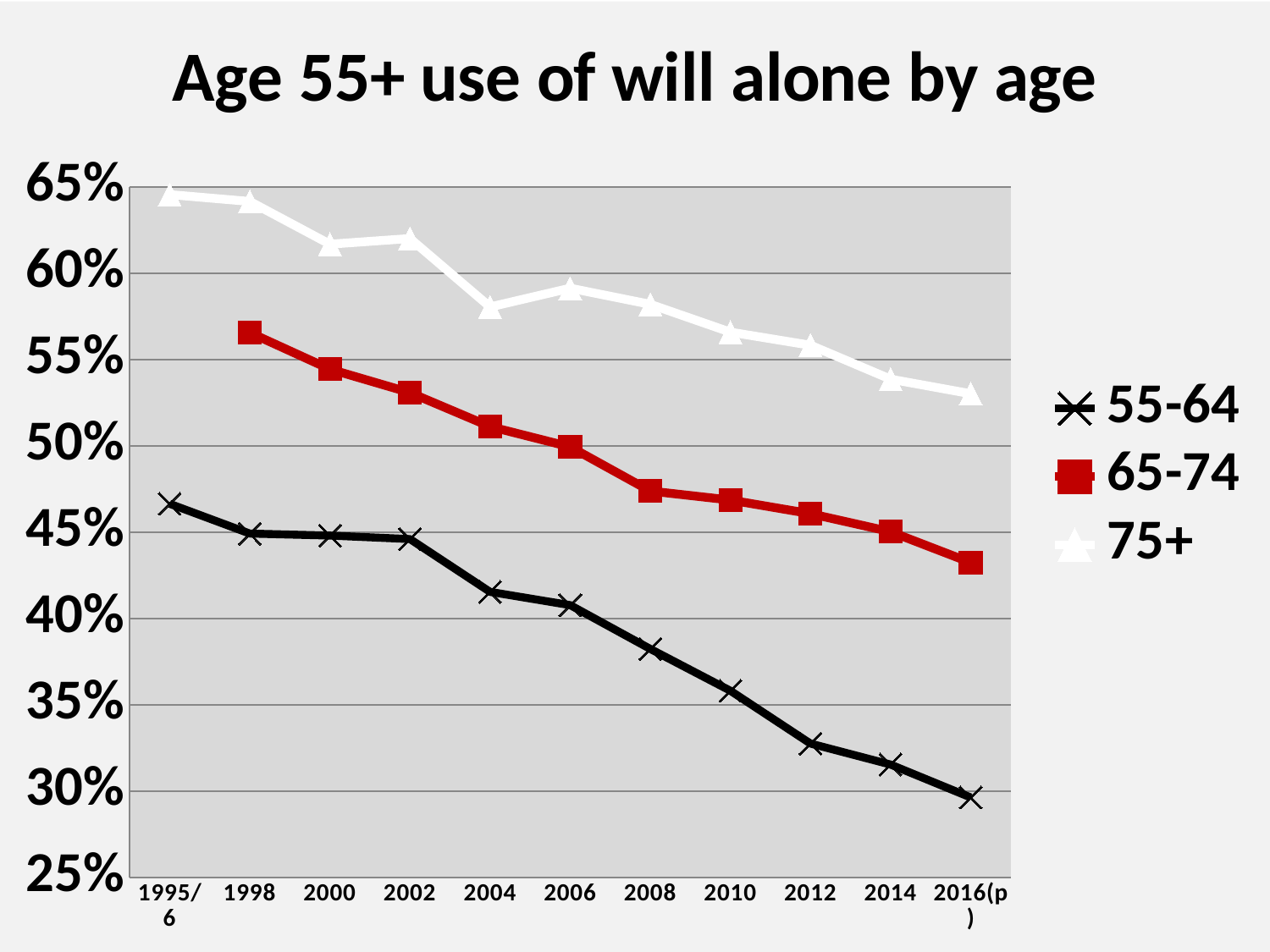
How many time points are shown on the x axis? 11 Is the value for 55-64 in 2012 greater or less than 35%? less In which year is the 75+ series at its lowest? 2016(p) How many series does the legend list? 3 Is the value for 75+ in 1995/6 greater or less than 60%? greater What kind of chart is shown on the slide? line chart In which year is the 55-64 series at its highest? 1995/6 Do the values for the 55-64 series rise or fall from 1995/6 to 2016(p)? fall Which age group has the highest value in 2010? 75+ Which age group has the lowest value in 2016(p)? 55-64 In 2008, which is larger: the value for 65-74 or the value for 55-64? 65-74 Is the value for 65-74 in 2016(p) greater or less than 45%? less